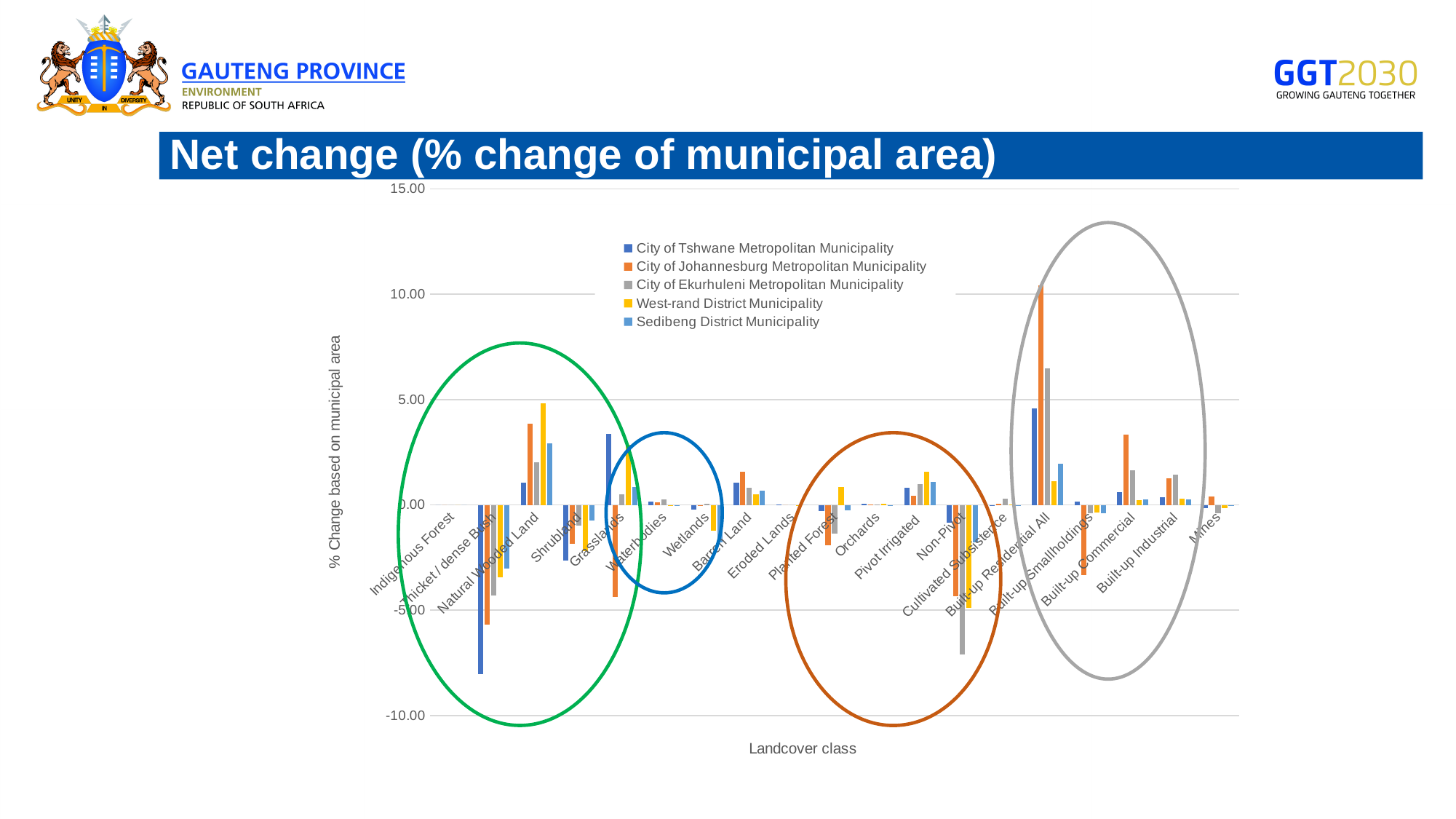
What kind of chart is shown on the slide? Bar chart Which municipality has the highest bar for Built-up Residential All? City of Johannesburg Metropolitan Municipality How many landcover classes are shown along the x axis? 19 For Natural Wooded Land, which is larger: the value for West-rand District Municipality or for City of Johannesburg Metropolitan Municipality? West-rand District Municipality Is the value for City of Tshwane Metropolitan Municipality at Thicket / dense Bush greater or less than -5.00? less Is the value for City of Ekurhuleni Metropolitan Municipality at Cultivated Subsistence greater or less than -5.00? greater What is the title of the y axis? % Change based on municipal area Which landcover class has the lowest (most negative) bar for City of Tshwane Metropolitan Municipality? Thicket / dense Bush What is the title of the x axis? Landcover class How many series does the legend list? 5 Is the value for City of Johannesburg Metropolitan Municipality at Built-up Residential All greater or less than 5.00? greater